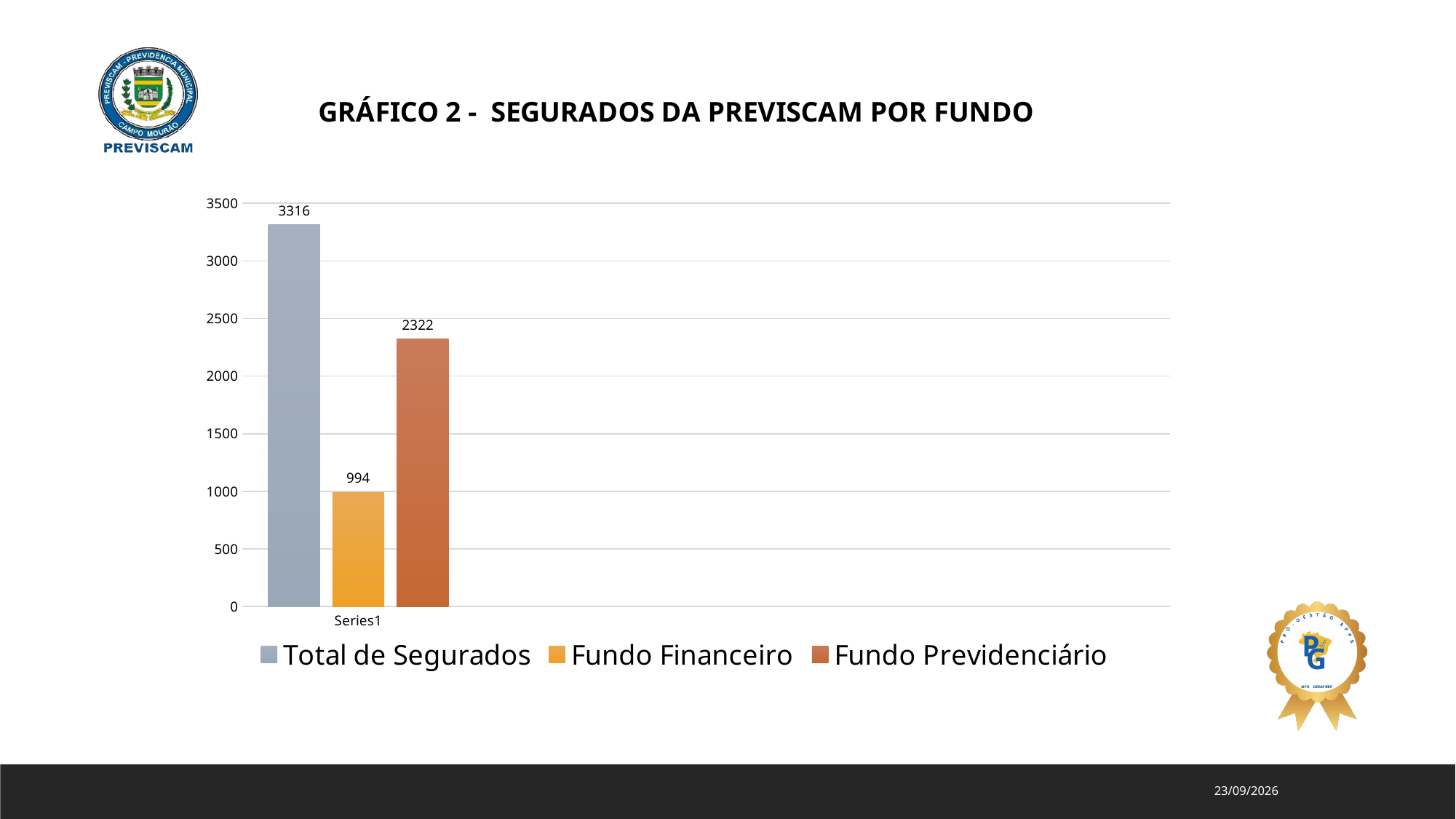
Which series has the lowest value? Fundo Financeiro How many series does the legend list? 3 What is the difference between Total de Segurados and Fundo Previdenciário? 994 Which series has the highest value? Total de Segurados What is the title of the chart? GRÁFICO 2 - SEGURADOS DA PREVISCAM POR FUNDO What kind of chart is shown on the slide? bar chart What is the difference between Fundo Previdenciário and Fundo Financeiro? 1328 What is the value for Fundo Previdenciário? 2322 Which is larger, Fundo Financeiro or Fundo Previdenciário? Fundo Previdenciário What is the value for Total de Segurados? 3316 What is the value for Fundo Financeiro? 994 Is the value for Fundo Financeiro greater or less than 1000? less